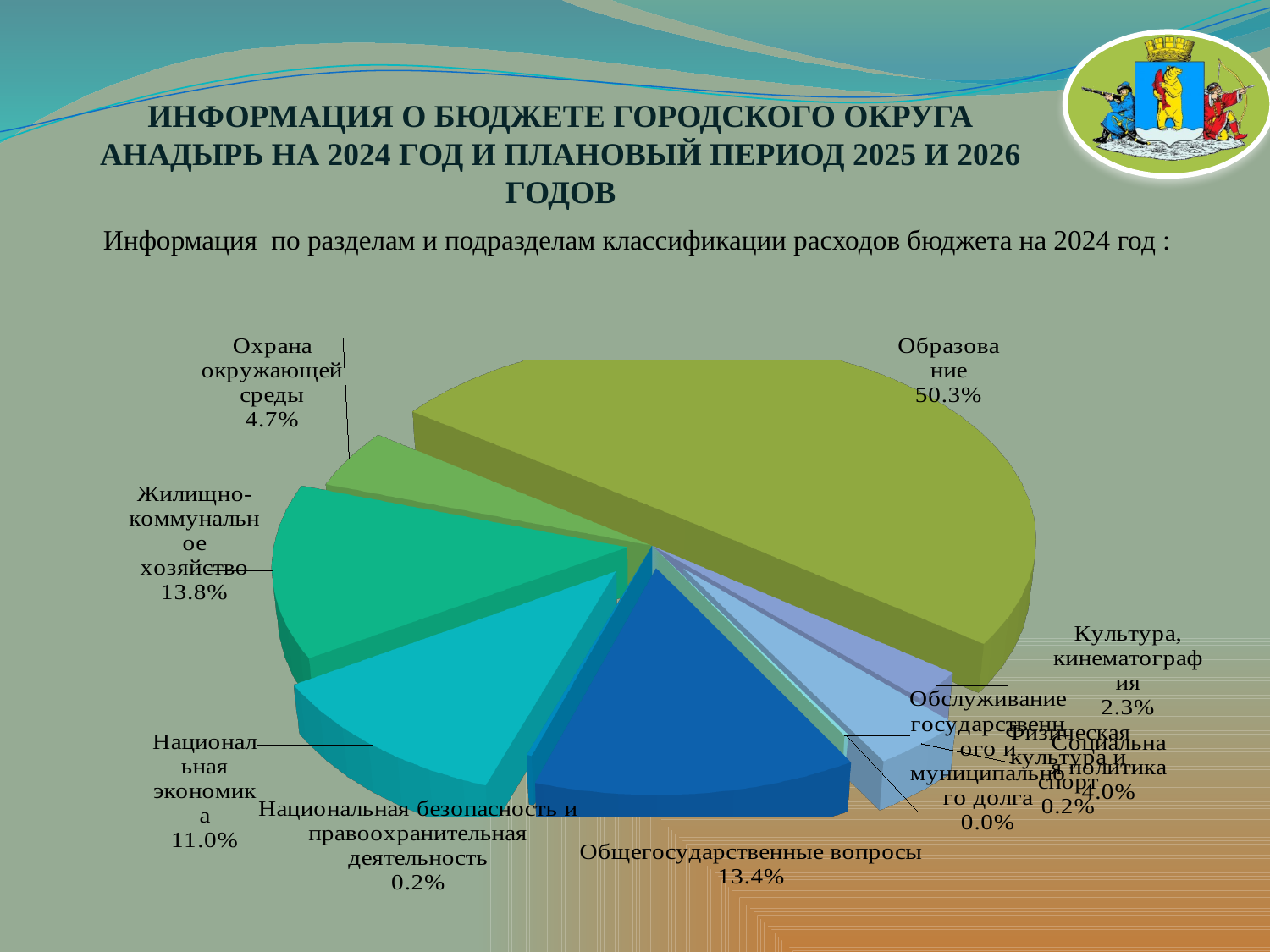
What kind of chart is shown on the slide? Pie chart What is the difference in percentage points between Национальная экономика and Социальная политика? 7.0 Which category has the largest slice of the pie? Образование How many categories are shown in the pie chart? 10 What is the difference in percentage points between Образование and Жилищно-коммунальное хозяйство? 36.5 What share of the pie does Образование have? 50.3% What is the value shown for Культура, кинематография? 2.3% What is the value shown for Жилищно-коммунальное хозяйство? 13.8% Which category has the smallest share of the pie? Обслуживание государственного и муниципального долга What is the value for Охрана окружающей среды? 4.7% Which is larger: Жилищно-коммунальное хозяйство or Общегосударственные вопросы? Жилищно-коммунальное хозяйство What percentage is shown for Национальная экономика? 11.0%